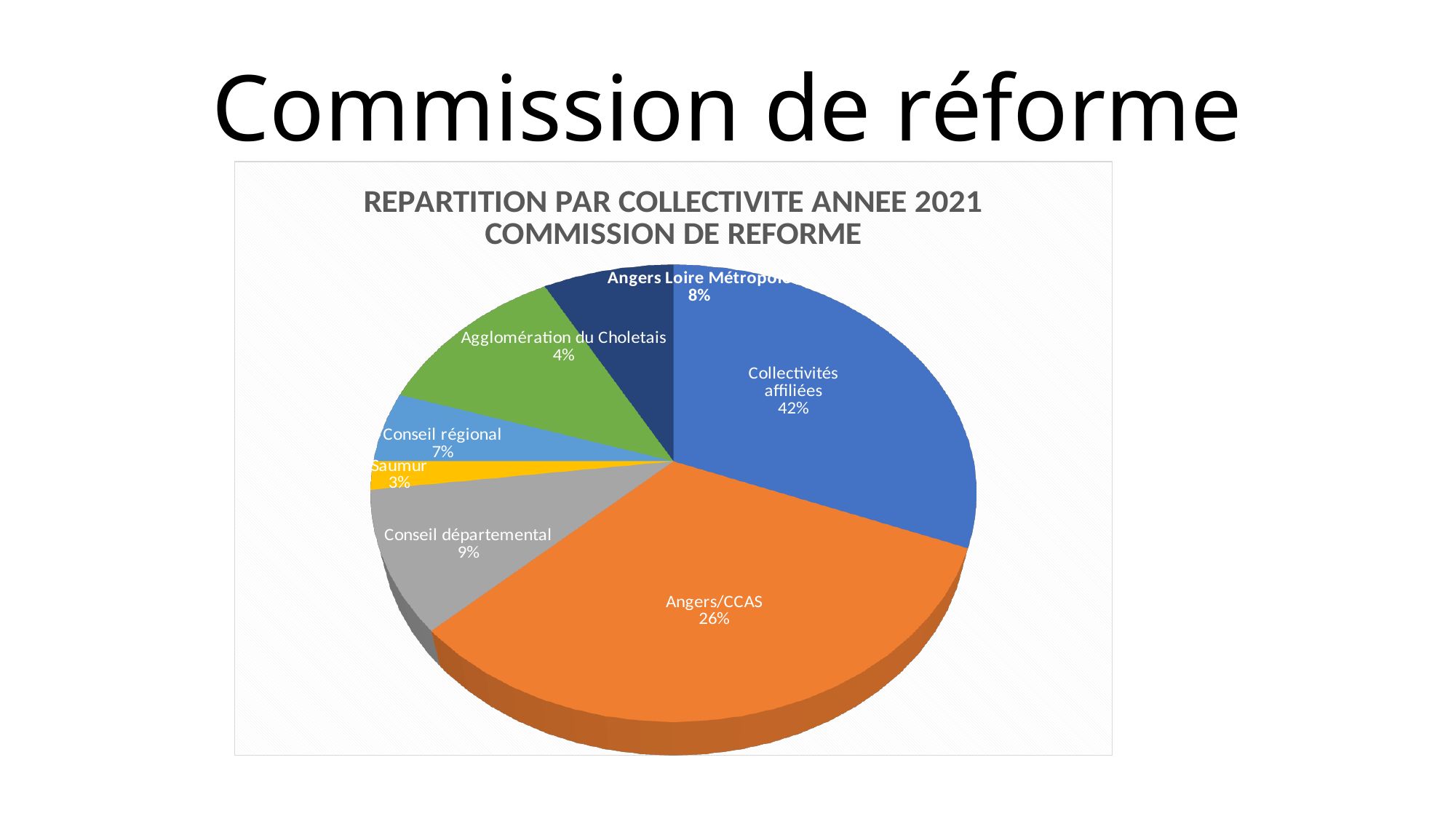
How many slices does the pie chart have? 7 Which category has the smallest slice? Saumur What type of chart is shown on the slide? Pie chart What is the difference between Collectivités affiliées and Angers/CCAS? 16% What is the value for Agglomération du Choletais? 4% Which category has the largest slice? Collectivités affiliées Which is larger, Angers Loire Métropole or Conseil régional? Angers Loire Métropole What share of the pie is Angers/CCAS? 26% What is the value for Conseil régional? 7% What is the value for Conseil départemental? 9% What is the chart's title? REPARTITION PAR COLLECTIVITE ANNEE 2021 COMMISSION DE REFORME What share of the pie is Collectivités affiliées? 42%